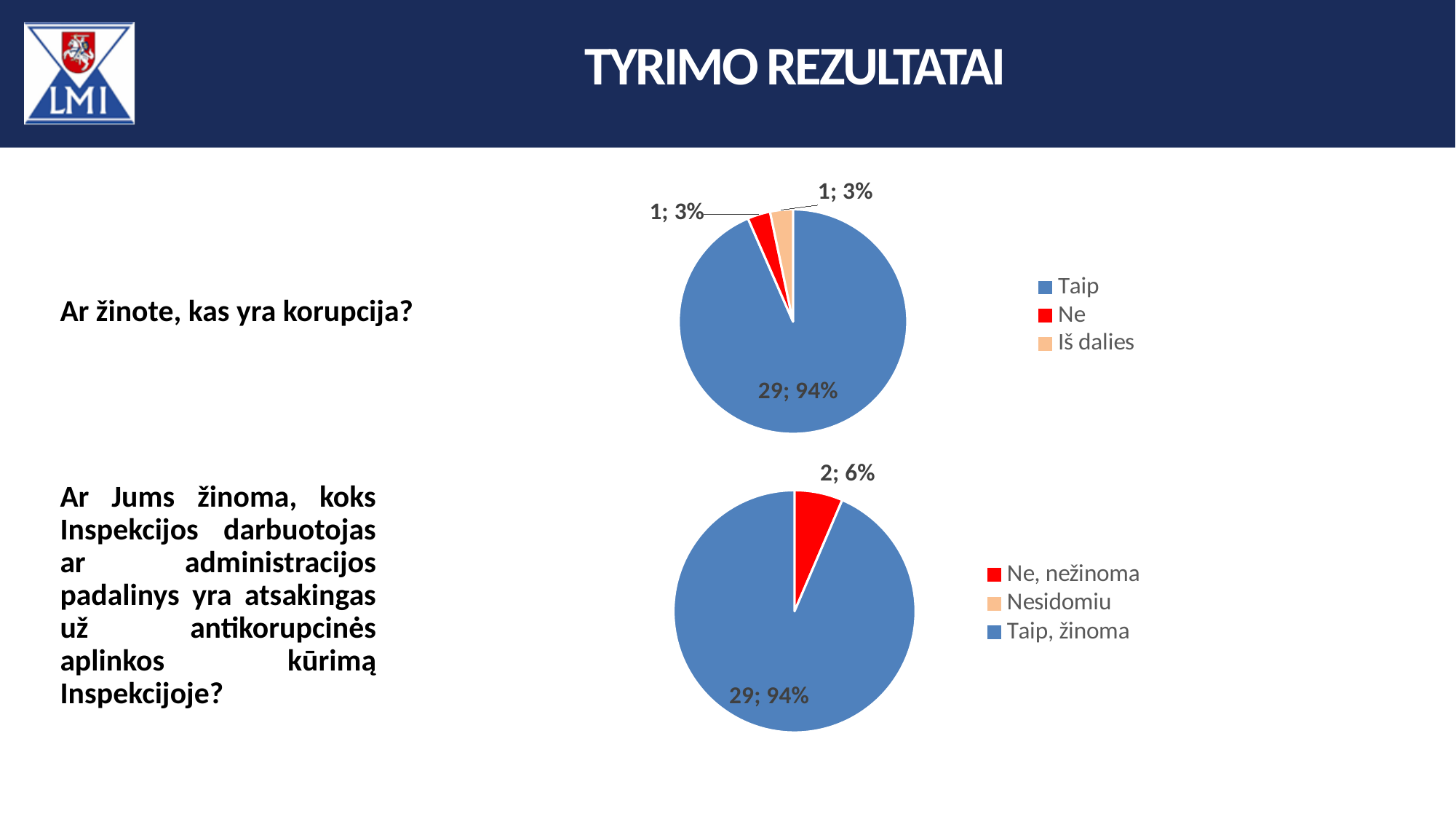
In the top pie chart, what share of the pie does the Taip slice represent? 94% In the bottom pie chart, what is the difference in count between the Taip, žinoma slice and the Ne, nežinoma slice? 27 In the bottom pie chart, what is the data label shown for the Ne, nežinoma slice? 2; 6% In the top pie chart, what is the data label shown for the Taip slice? 29; 94% In the top pie chart, which category has the largest slice? Taip In the top pie chart, what share of the pie does the Ne slice represent? 3% In the bottom pie chart, which category has the largest slice? Taip, žinoma In the top pie chart, how many entries does the legend list? 3 What kind of chart is the top chart on the slide? Pie chart In the top pie chart, what colour is the Iš dalies slice? Light orange In the bottom pie chart, how many entries does the legend list? 3 In the bottom pie chart, what share of the pie does the Taip, žinoma slice represent? 94%